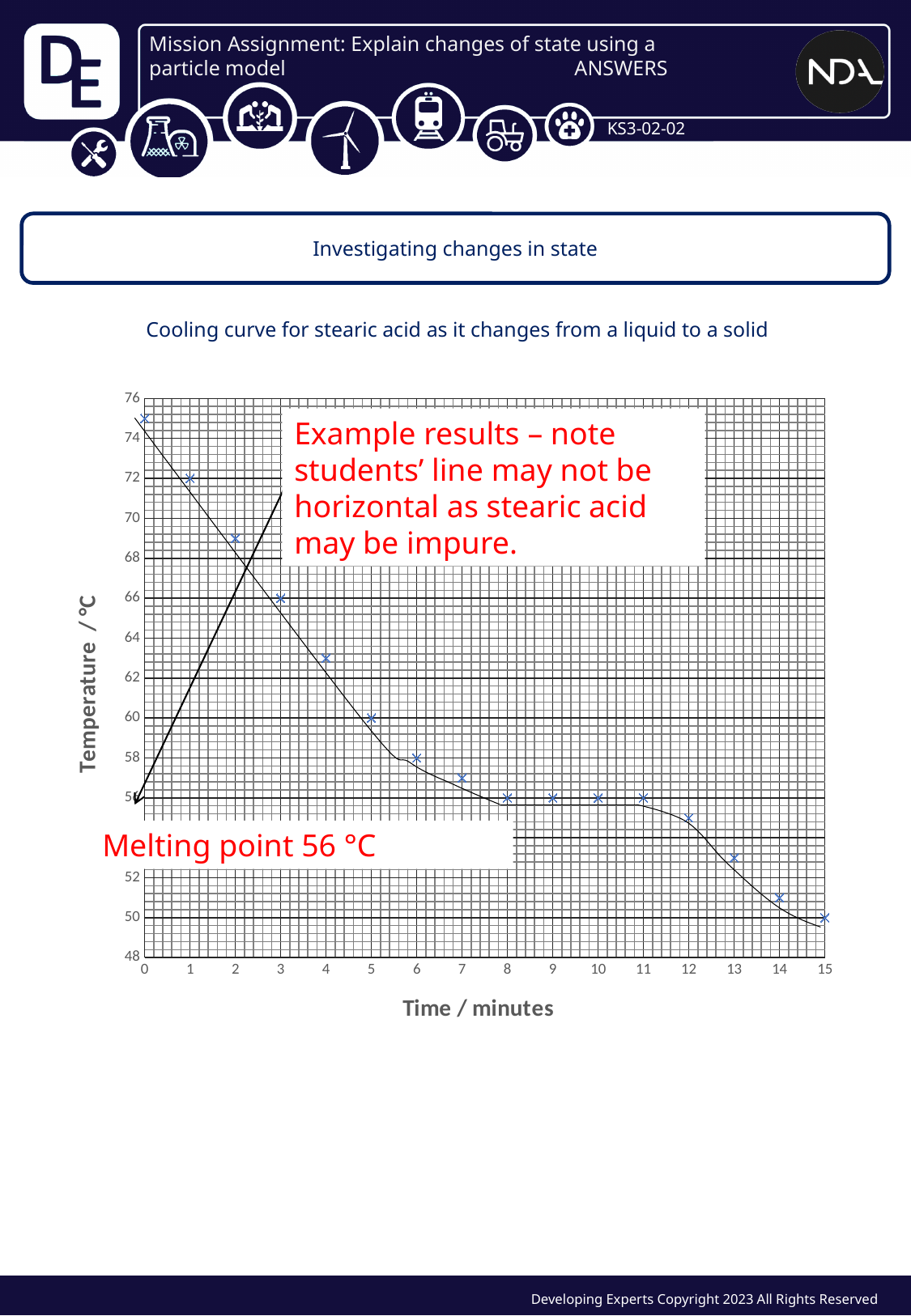
What is the title of the chart? Cooling curve for stearic acid as it changes from a liquid to a solid What is the temperature at 1 minute? 72 What is the label of the x axis? Time / minutes At which time is the temperature lowest? 15 minutes Does the temperature rise or fall as time increases along the x axis? fall Is the temperature at 13 minutes greater or less than 52? greater Which is higher, the temperature at 2 minutes or at 12 minutes? 2 minutes Is the temperature at 4 minutes greater or less than 64? less At which time is the temperature highest? 0 minutes What kind of chart is shown on the slide? line chart What temperature is the melting point marked on the chart? 56 °C How many data points are plotted on the cooling curve? 16